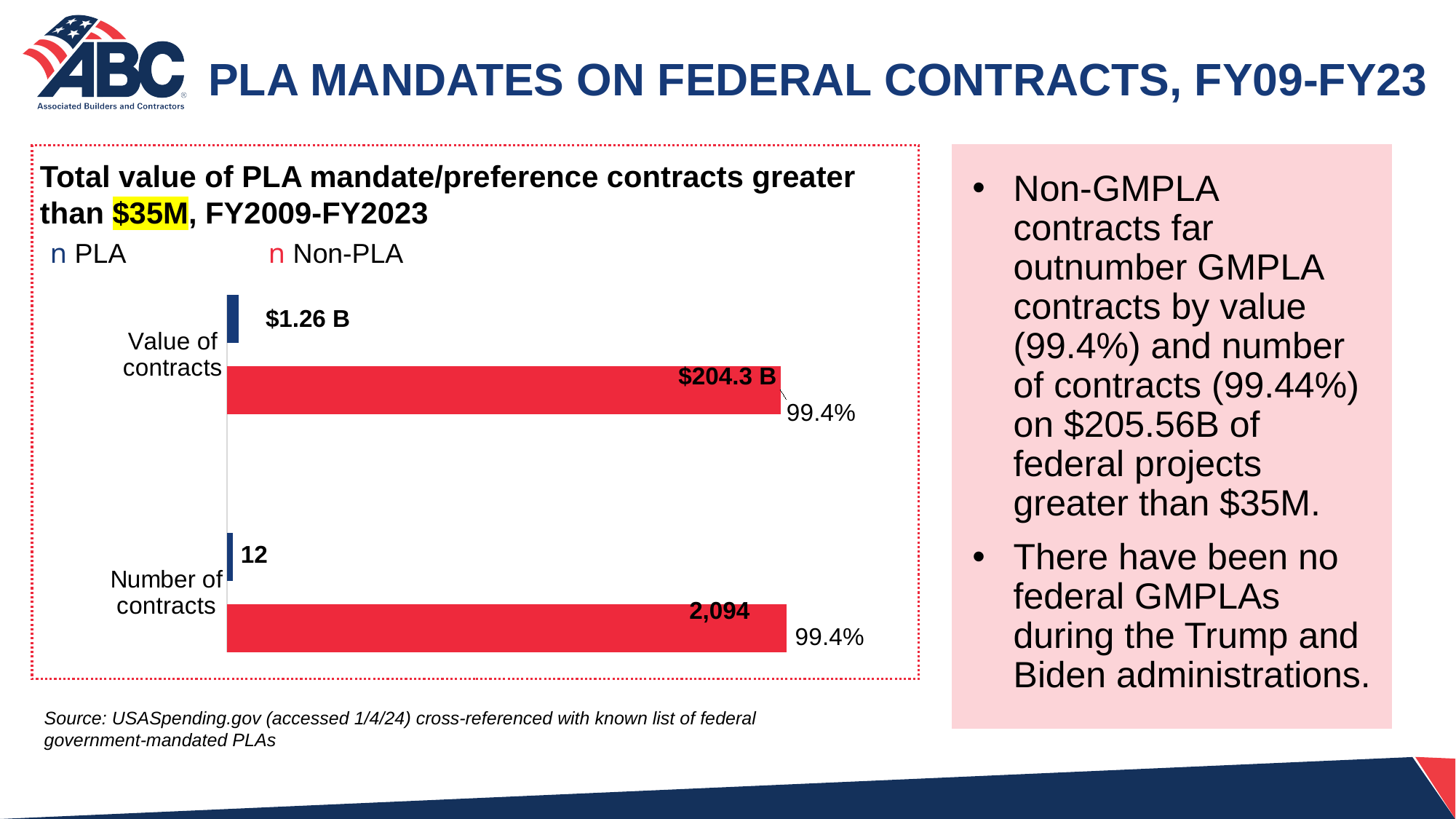
What is the difference between the Non-PLA and PLA number of contracts? 2,082 What is the value of contracts for Non-PLA? $204.3 B What percentage label is shown next to the Non-PLA bar for number of contracts? 99.4% What is the number of contracts for Non-PLA? 2,094 What kind of chart is shown? Bar chart Which series has the smaller number of contracts, PLA or Non-PLA? PLA What colour are the Non-PLA bars? Red How many series does the legend list? 2 Which series has the larger value of contracts, PLA or Non-PLA? Non-PLA How many categories are shown on the chart? 2 What is the value of contracts for PLA? $1.26 B What is the number of contracts for PLA? 12